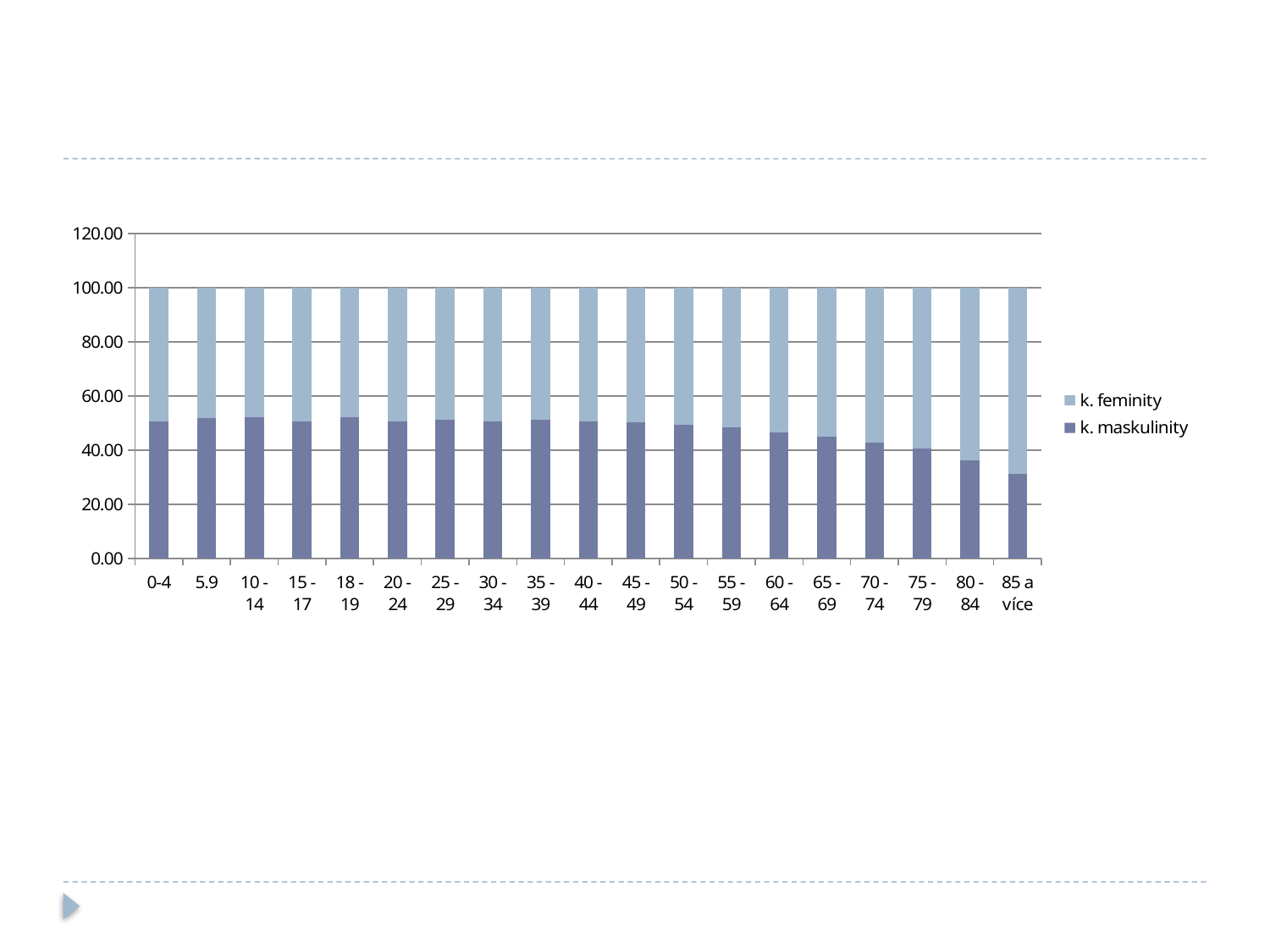
Is the value of k. maskulinity for the 0-4 category greater or less than 40.00? greater How many age categories are shown on the x axis? 19 What are the two entries listed in the legend? k. feminity and k. maskulinity How many series does the legend list? 2 Does the value of k. maskulinity rise or fall from the 55-59 category to the 85 a více category? fall Which category has the lowest value for k. maskulinity? 85 a více Is the value of k. maskulinity for the 85 a více category greater or less than 40.00? less What kind of chart is shown on the slide? bar chart Which category has the highest value for k. feminity? 85 a více Which category has the larger k. maskulinity value, 0-4 or 85 a více? 0-4 In the 85 a více category, which series has the larger value, k. feminity or k. maskulinity? k. feminity What is the total height of the stacked bar for the 0-4 category? 100.00